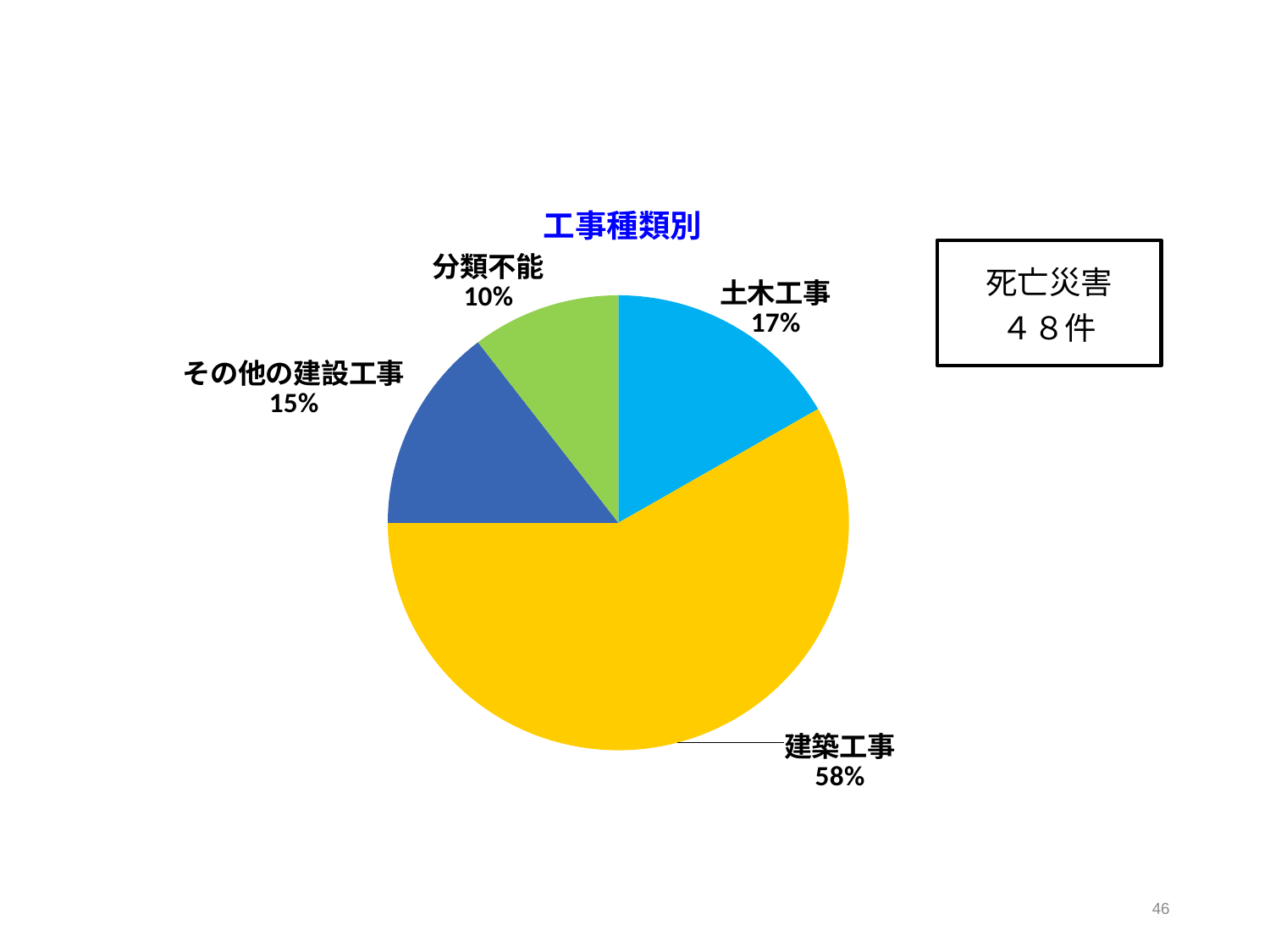
What share of the pie does 分類不能 represent? 10% What share of the pie does 土木工事 represent? 17% What is the difference in percentage points between 建築工事 and 土木工事? 41 Which category has the smallest share of the pie? 分類不能 Which category has the largest share of the pie? 建築工事 What share of the pie does 建築工事 represent? 58% What type of chart is shown on the slide? pie chart How many categories are shown in the pie chart? 4 Which is larger, the share for 土木工事 or the share for その他の建設工事? 土木工事 What colour is the slice for 建築工事? yellow What is the title of the chart? 工事種類別